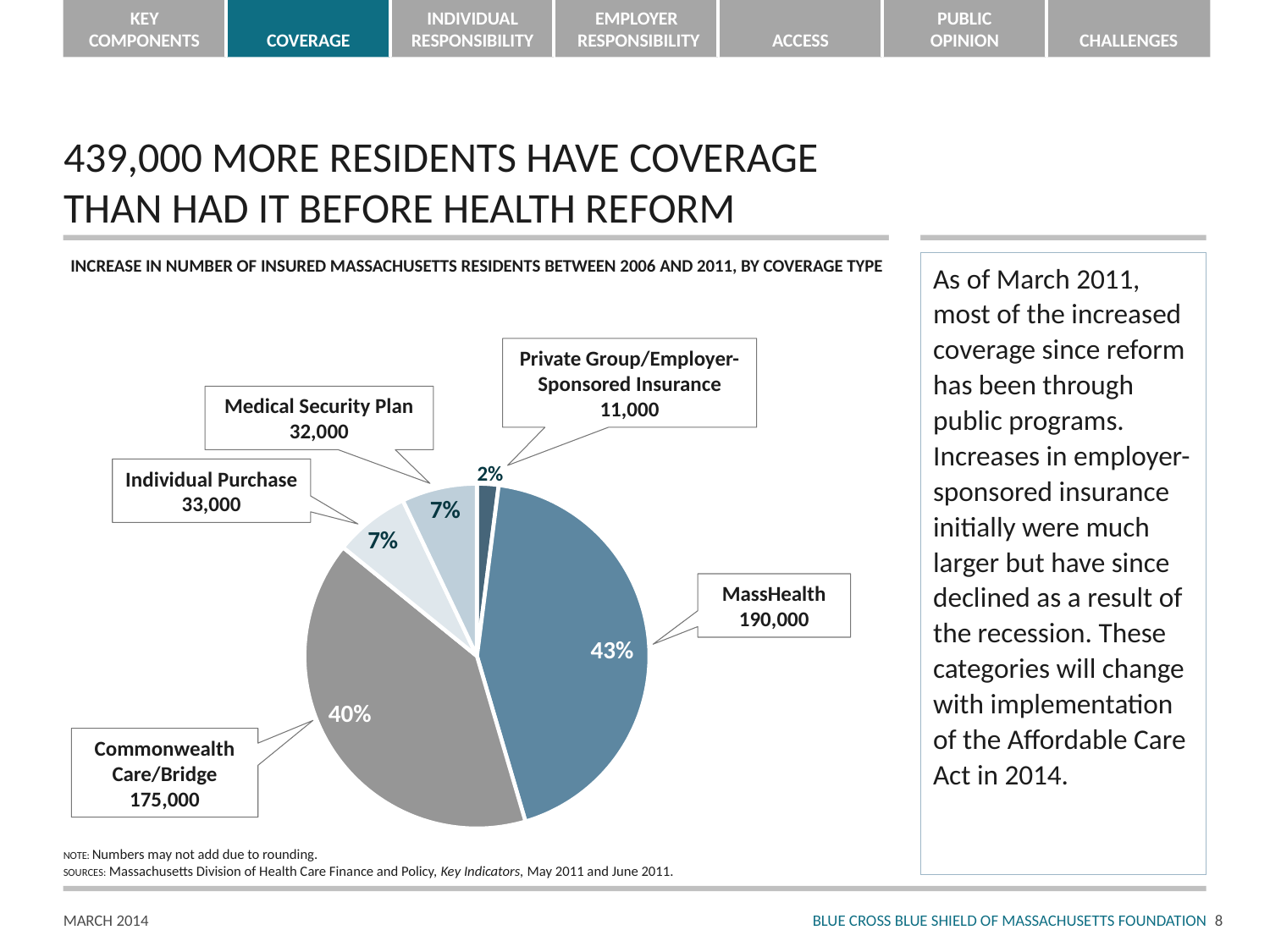
What is the value shown for Private Group/Employer-Sponsored Insurance? 11,000 What is the value shown for Medical Security Plan? 32,000 What percentage share of the pie does Individual Purchase represent? 7% What is the increase in insured residents through MassHealth? 190,000 How many coverage types are shown in the pie chart? 5 Which is larger, the value for Individual Purchase or the value for Private Group/Employer-Sponsored Insurance? Individual Purchase What type of chart is shown on the slide? Pie chart Which coverage type accounts for the largest share of the pie? MassHealth Which coverage type accounts for the smallest share of the pie? Private Group/Employer-Sponsored Insurance What is the value shown for Commonwealth Care/Bridge? 175,000 What percentage share of the pie does Commonwealth Care/Bridge represent? 40% What is the difference between the MassHealth value and the Commonwealth Care/Bridge value? 15,000